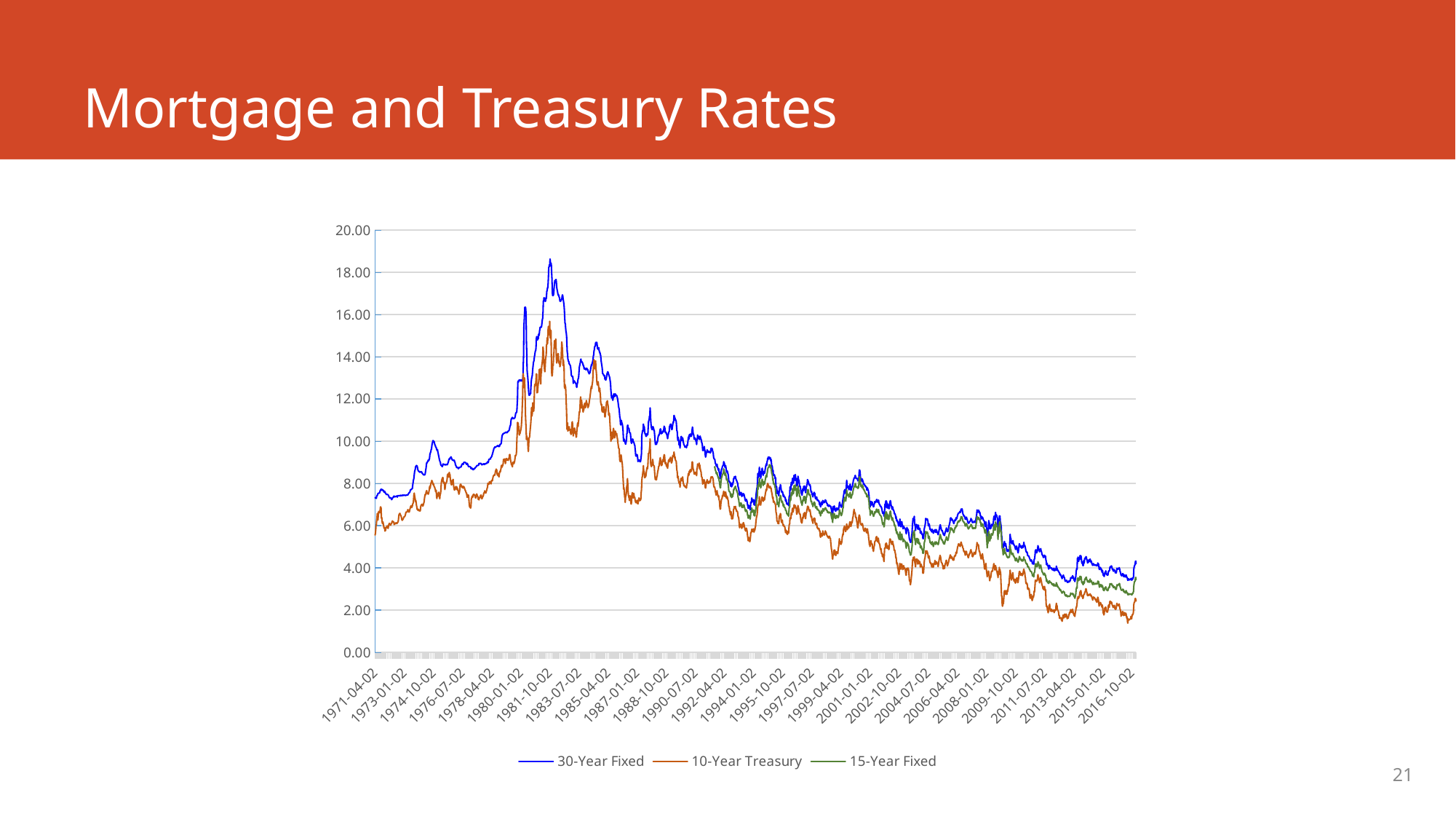
Which series reaches the highest peak on the chart? 30-Year Fixed Which colour is used for the 10-Year Treasury series? Orange What is the title of the slide? Mortgage and Treasury Rates What type of chart is shown on the slide? Line chart Is the value of the 30-Year Fixed series at 1971-04-02 greater or less than 6.00? greater Is the value of the 15-Year Fixed series at 2016-10-02 greater or less than 6.00? less Is the peak value of the 30-Year Fixed series greater or less than 16.00? greater Does the 30-Year Fixed series generally rise or fall from 1971-04-02 to 1981-10-02? Rise At 2016-10-02, which is higher: the 30-Year Fixed series or the 10-Year Treasury series? 30-Year Fixed Do the rates generally rise or fall from 1981-10-02 to 2016-10-02? Fall How many series does the legend list? 3